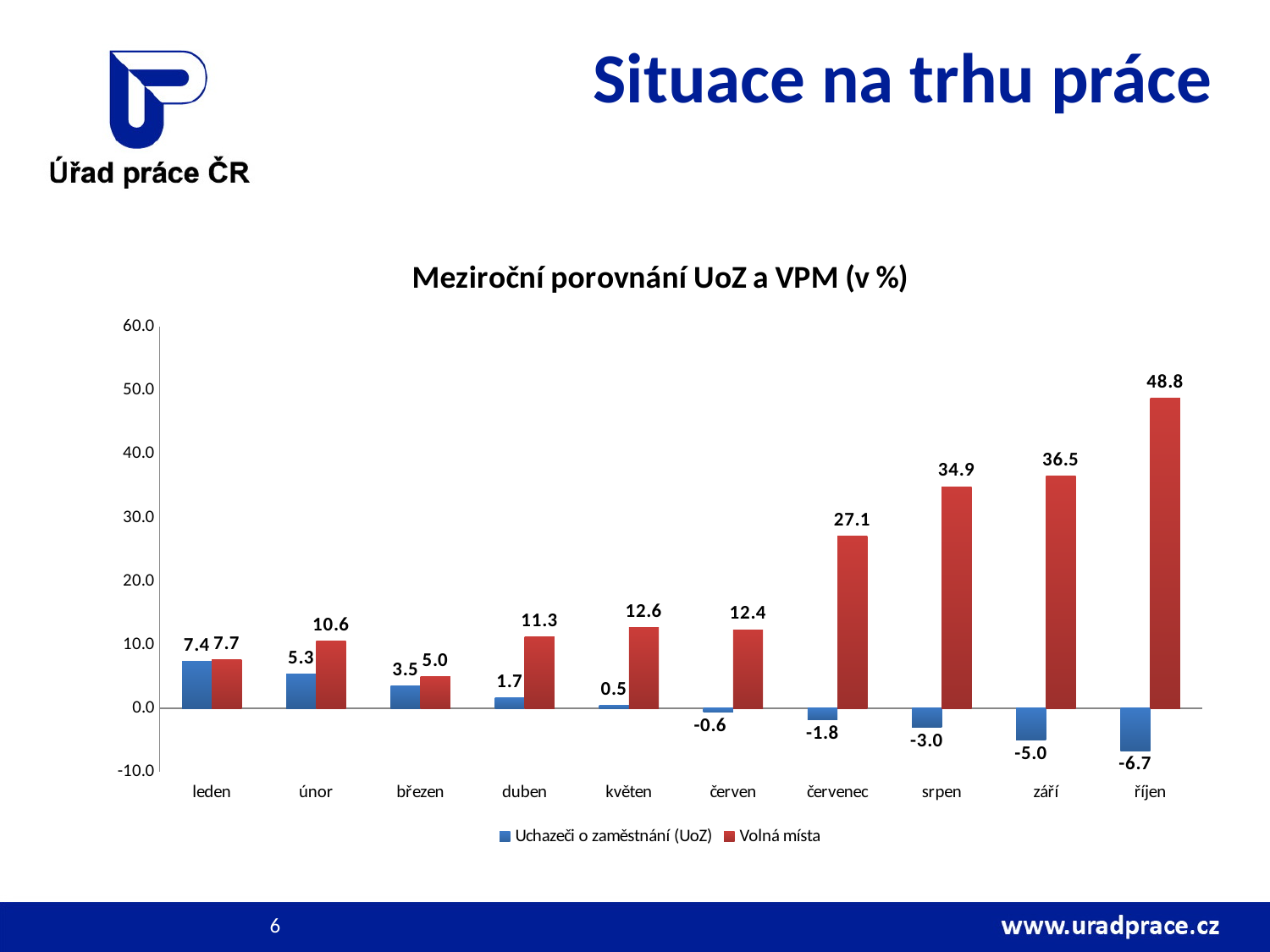
Which month has the highest value for Volná místa? říjen Do the values for Uchazeči o zaměstnání (UoZ) rise or fall from leden to říjen? fall Is the value for Volná místa in září greater or less than 30.0? greater What is the value for Volná místa in říjen? 48.8 What kind of chart is shown on the slide? bar chart What is the value for Uchazeči o zaměstnání (UoZ) in leden? 7.4 Which is larger, the Volná místa value for květen or for červen? květen Which month has the lowest value for Uchazeči o zaměstnání (UoZ)? říjen How many months are shown on the x axis? 10 What is the value for Uchazeči o zaměstnání (UoZ) in září? -5.0 How many series does the legend list? 2 What is the difference between the Volná místa values for srpen and červenec? 7.8